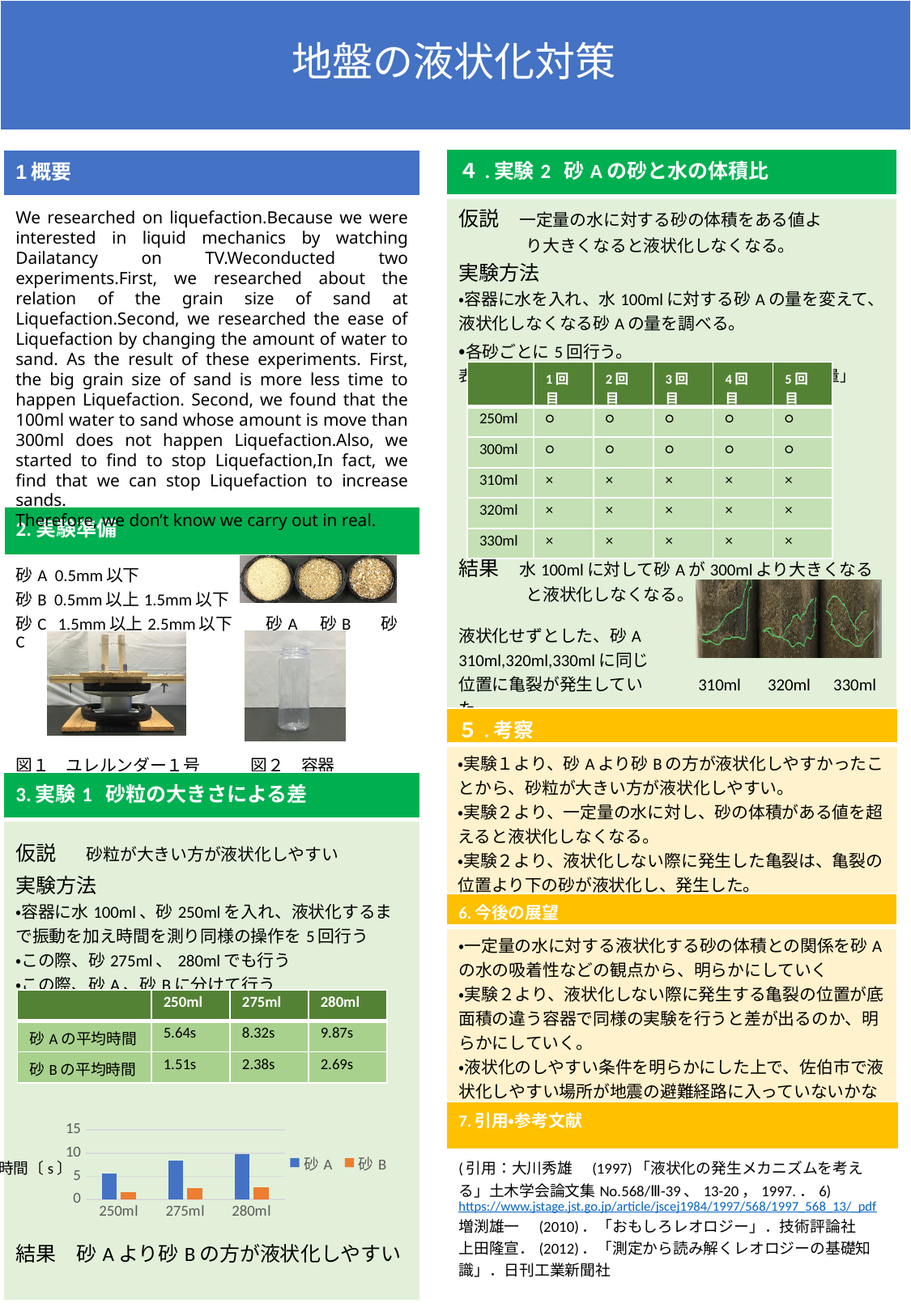
In the bar chart, which is larger at 275ml: 砂 A or 砂 B? 砂 A In the bar chart, at which category is the value for 砂 B lowest? 250ml How many series does the legend of the bar chart list? 2 In the bar chart, at which category is the value for 砂 A highest? 280ml In the bar chart, is the value for 砂 A at 250ml greater or less than 10? less In the bar chart, is the value for 砂 B at 280ml greater or less than 5? less In the bar chart, is the value for 砂 A at 280ml greater or less than 5? greater What kind of chart is shown at the bottom of the left column? bar chart How many categories are shown on the x axis of the bar chart? 3 What are the two legend entries of the bar chart? 砂 A, 砂 B In the bar chart, do the values for 砂 A rise or fall from 250ml to 280ml? rise What is the label on the vertical axis of the bar chart? 時間〔s〕